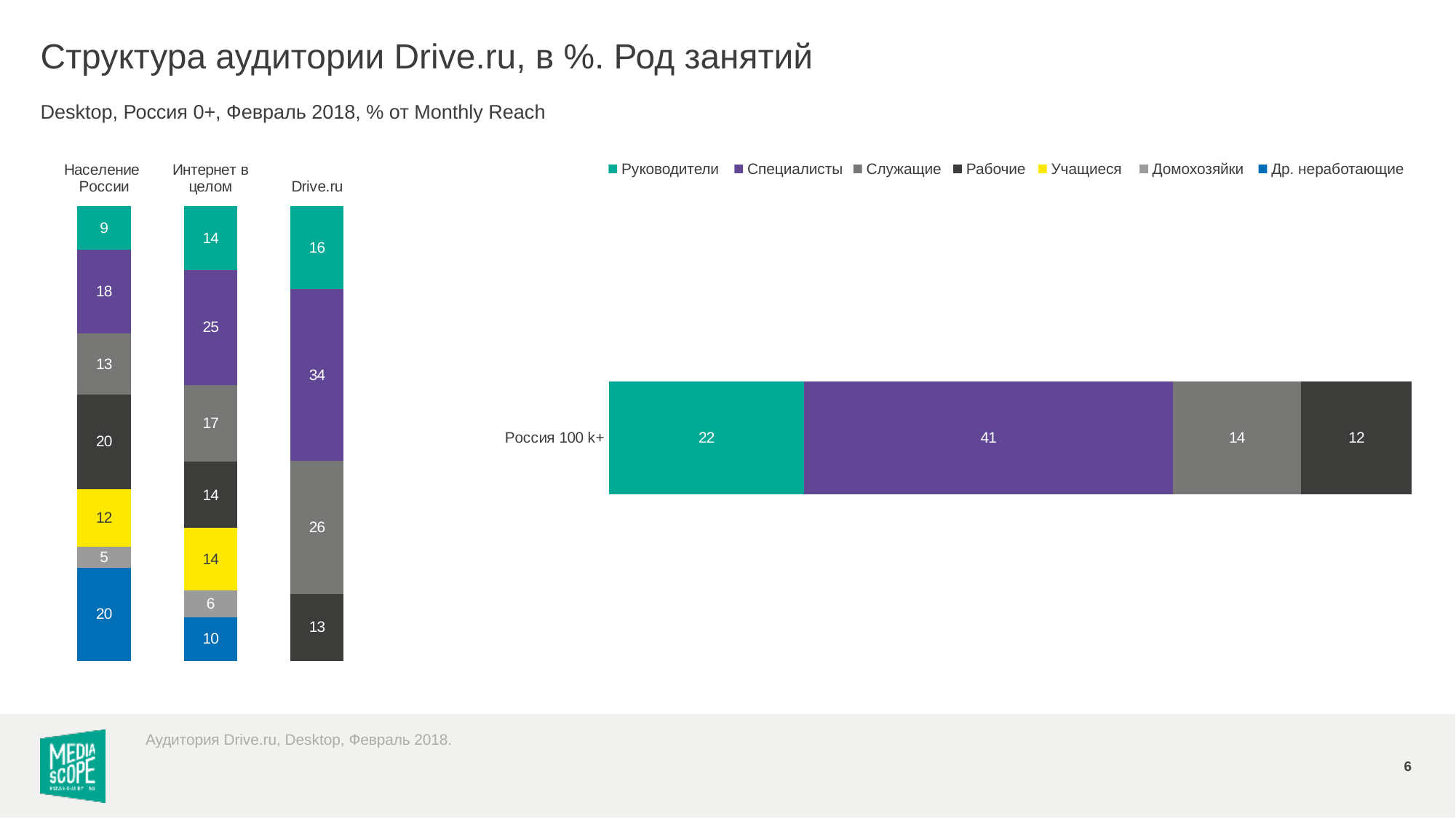
In the left chart, what is the value for Специалисты in the Drive.ru bar? 34 What type of chart is the right chart (Россия 100 k+)? Stacked bar chart In the left chart, what is the value for Учащиеся in the Интернет в целом bar? 14 How many series does the legend list? 7 In the left chart, what is the difference between the Специалисты values for Drive.ru and Население России? 16 In the right chart (Россия 100 k+), what is the value for Руководители? 22 How many bars (categories) does the left chart show? 3 In the left chart, which is larger: Служащие for Drive.ru or Служащие for Интернет в целом? Drive.ru In the left chart, which segment of the Население России bar is the smallest? Домохозяйки In the left chart, what is the value for Руководители in the Население России bar? 9 In the right chart (Россия 100 k+), what is the value for Специалисты? 41 In the left chart, which segment of the Drive.ru bar is the largest? Специалисты